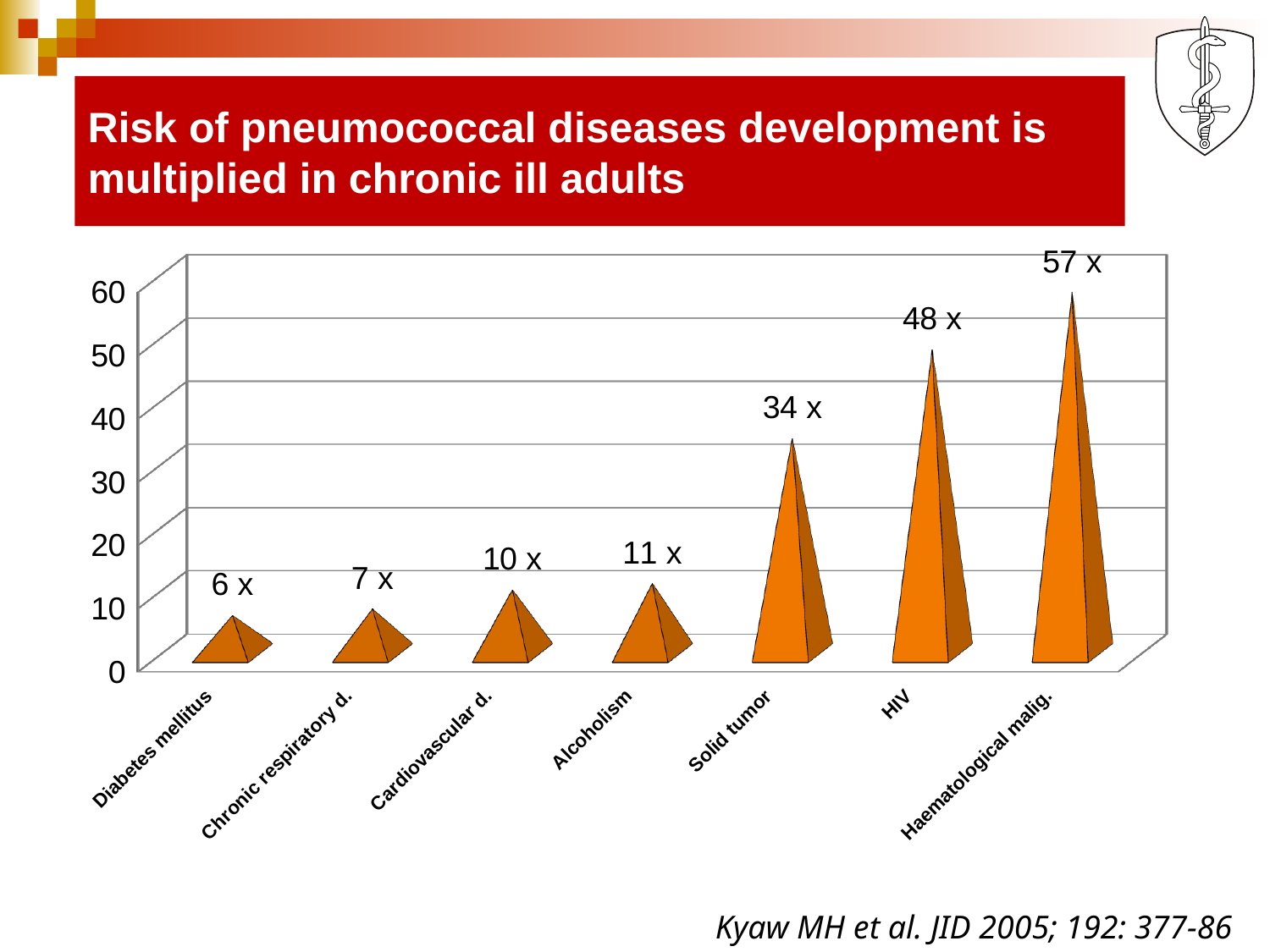
Which category has the lowest value? Diabetes mellitus How many categories are shown on the x axis? 7 What is the value shown for Solid tumor? 34 x Which is larger, the value for Cardiovascular d. or the value for Alcoholism? Alcoholism What is the difference between the values for Haematological malig. and HIV? 9 x Do the values rise or fall from left to right along the x axis? rise What is the difference between the values for Alcoholism and Chronic respiratory d.? 4 x What is the value shown for HIV? 48 x What kind of chart is shown on the slide? bar chart Which category has the highest value? Haematological malig. Is the value for Solid tumor greater or less than 30? greater What is the value shown for Diabetes mellitus? 6 x